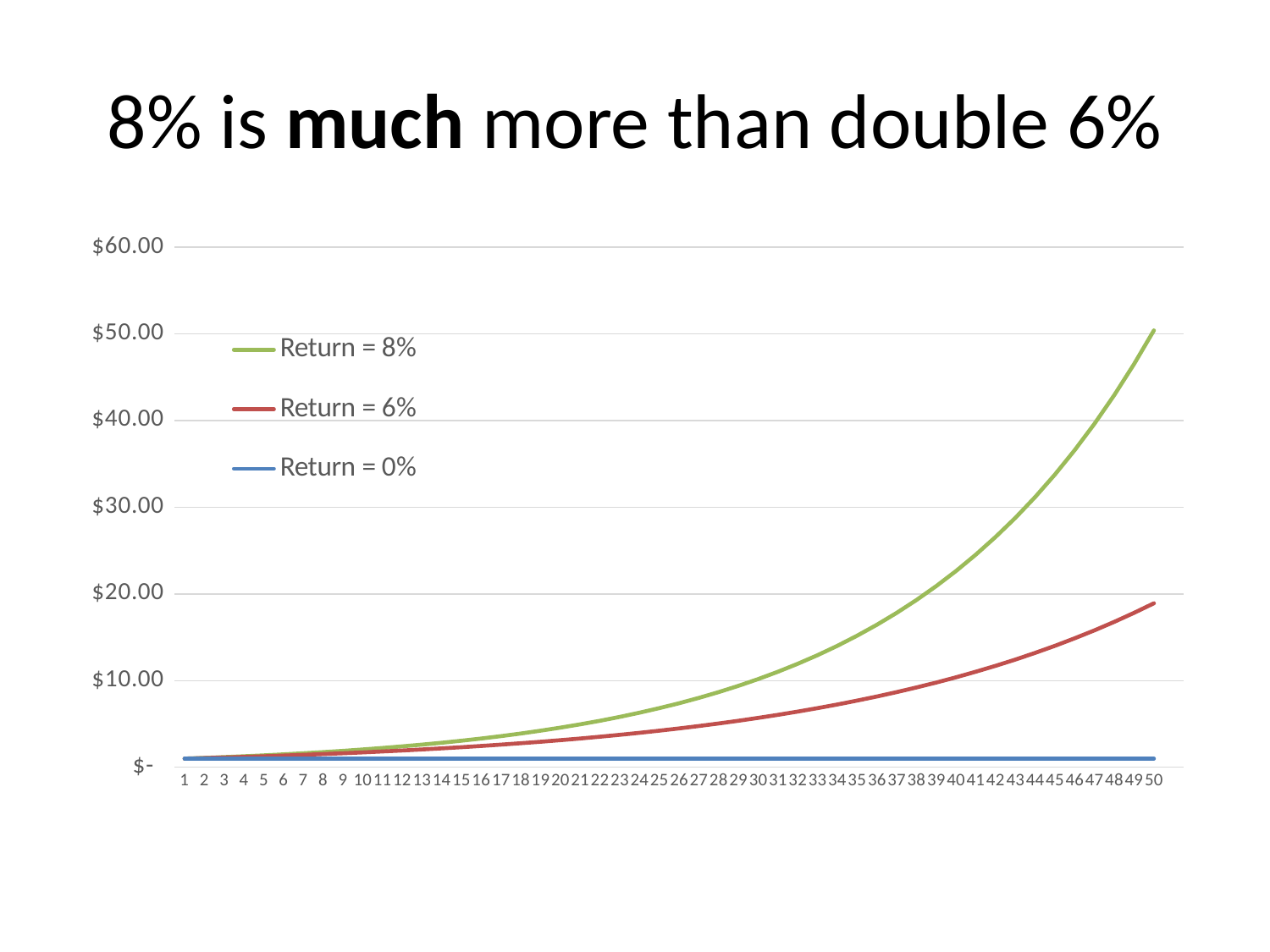
Do the values for Return = 0% rise, fall, or stay flat across the x axis? stay flat What is the title of the slide? 8% is much more than double 6% How many points are plotted along the x axis for each series? 50 Which series has the highest value at point 50? Return = 8% Is the value for Return = 6% at point 50 greater or less than $10.00? greater How many series does the legend list? 3 Is the value for Return = 8% at point 50 greater or less than $40.00? greater Do the values for Return = 8% rise or fall from point 1 to point 50? rise Which series has the lowest value at point 50? Return = 0% Is the value for Return = 0% at point 50 greater or less than $10.00? less At point 40, which is larger: Return = 8% or Return = 6%? Return = 8% What kind of chart is shown on the slide? line chart